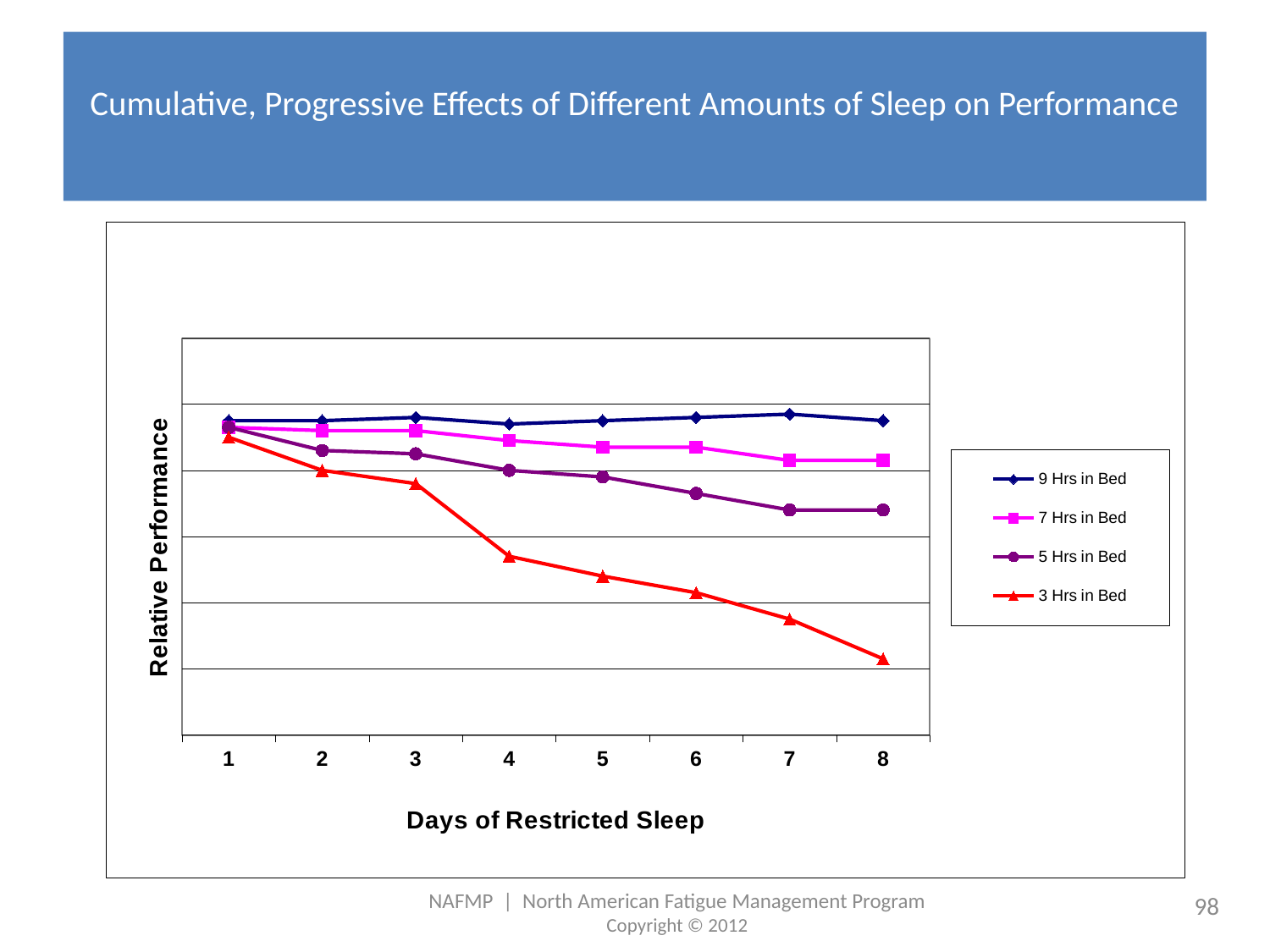
Which series has the lowest relative performance on day 8? 3 Hrs in Bed Which series shows the steepest decline in relative performance over the 8 days? 3 Hrs in Bed Does the relative performance for 5 Hrs in Bed rise or fall from day 1 to day 8? Fall On day 4, which series has the higher relative performance: 5 Hrs in Bed or 3 Hrs in Bed? 5 Hrs in Bed How many days of restricted sleep are plotted along the x axis? 8 Does the relative performance for 3 Hrs in Bed rise or fall as the days of restricted sleep increase? Fall On day 6, which series has the higher relative performance: 7 Hrs in Bed or 5 Hrs in Bed? 7 Hrs in Bed What is the title of the y axis? Relative Performance How many series does the legend list? 4 Which series has the highest relative performance on day 8? 9 Hrs in Bed What is the title of the x axis? Days of Restricted Sleep What kind of chart is shown on the slide? Line chart